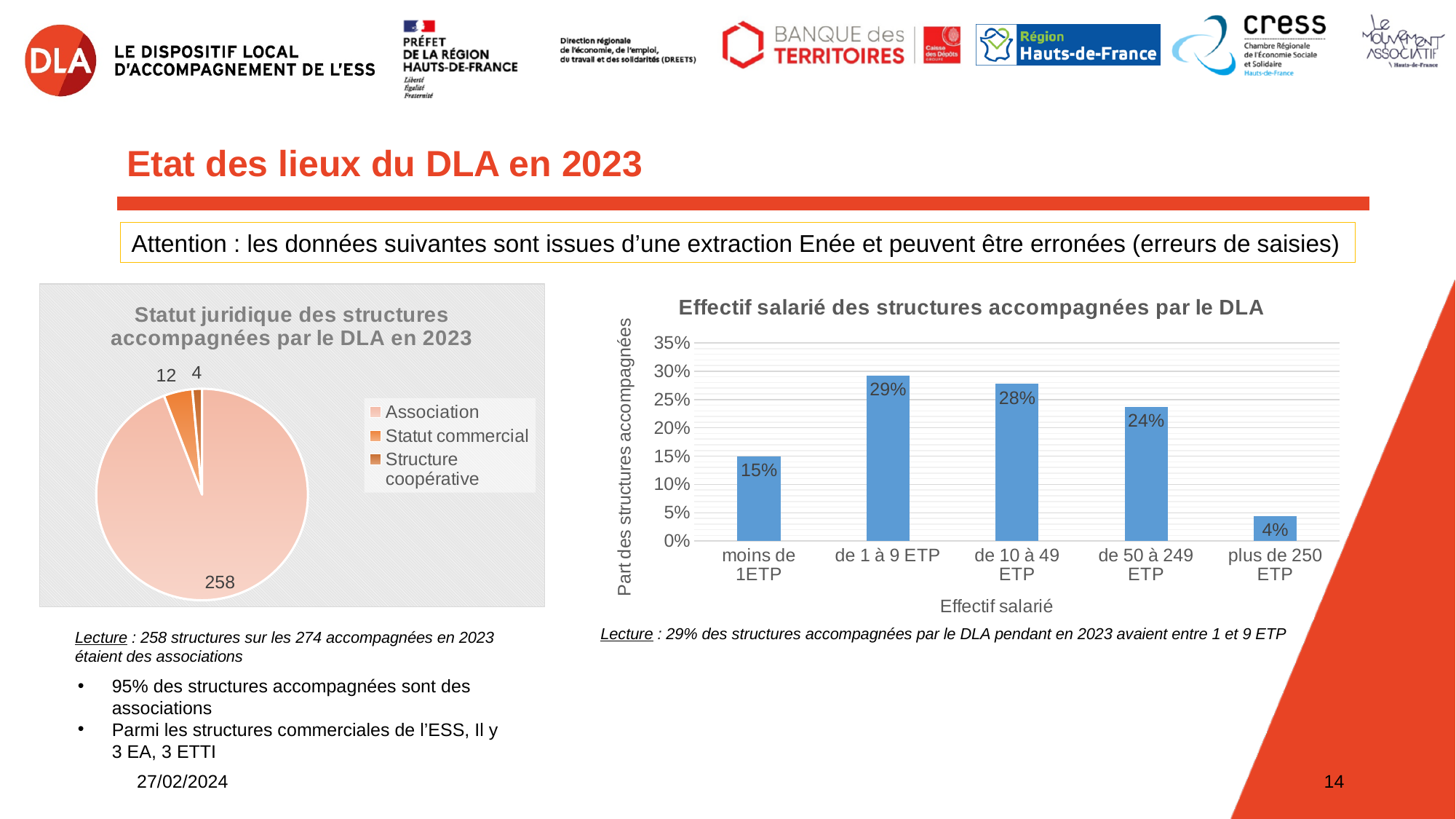
What kind of chart is the 'Statut juridique des structures accompagnées par le DLA en 2023' chart? pie chart In the 'Statut juridique' pie chart, what is the value for Association? 258 In the 'Effectif salarié' bar chart, what is the difference between the values for 'de 50 à 249 ETP' and 'plus de 250 ETP'? 20% How many categories does the legend of the 'Statut juridique' pie chart list? 3 In the 'Effectif salarié' bar chart, what is the value for 'de 10 à 49 ETP'? 28% In the 'Statut juridique' pie chart, what is the difference between the Statut commercial and Structure coopérative values? 8 In the 'Statut juridique' pie chart, which category has the smallest value? Structure coopérative How many categories are shown on the x axis of the 'Effectif salarié' bar chart? 5 In the 'Statut juridique' pie chart, what is the value for Statut commercial? 12 In the 'Effectif salarié' bar chart, which category has the lowest value? plus de 250 ETP What kind of chart is the 'Effectif salarié des structures accompagnées par le DLA' chart? bar chart In the 'Effectif salarié' bar chart, which category has the highest value? de 1 à 9 ETP